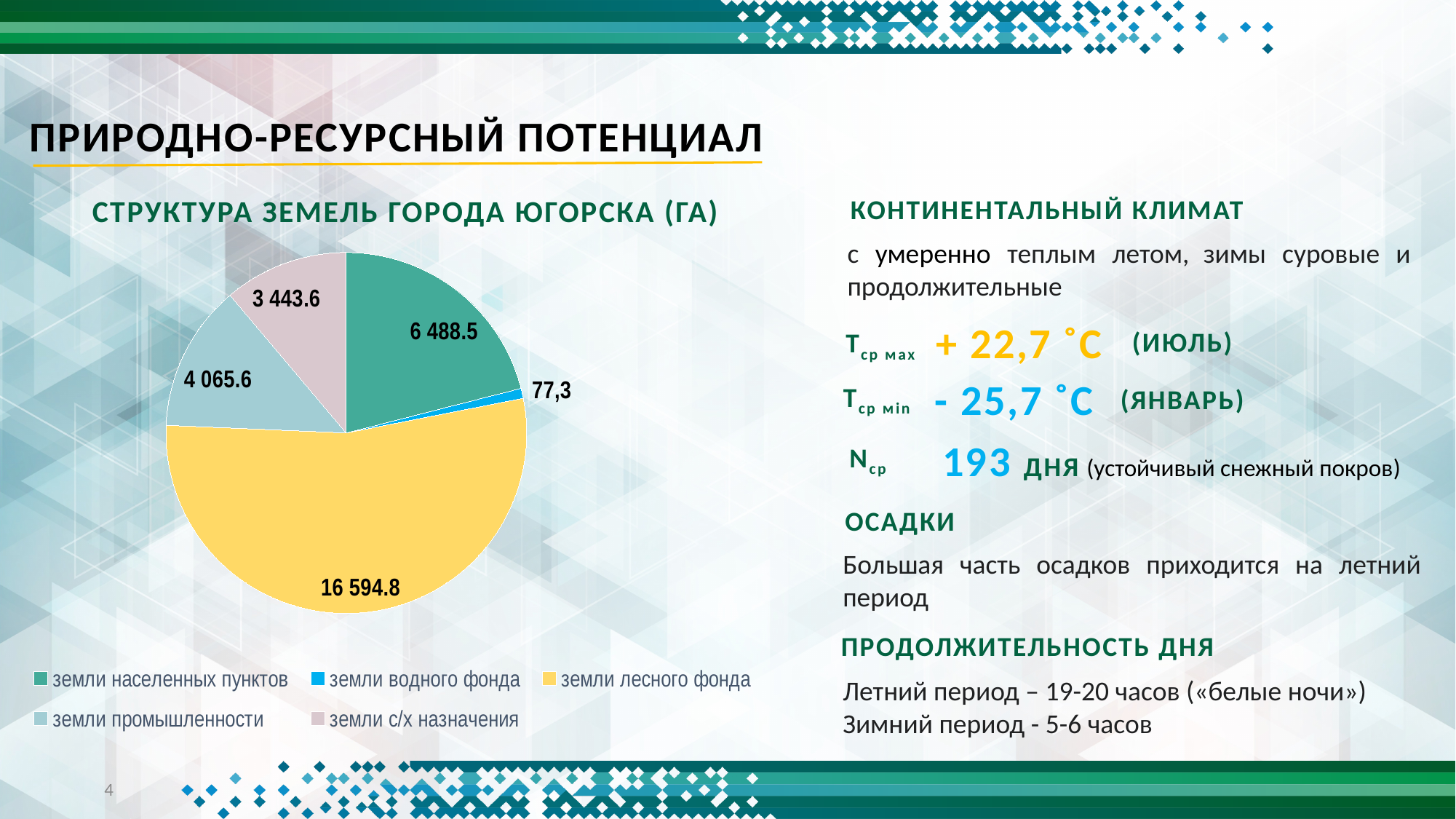
How many categories does the pie chart show? 5 What is the difference between the values for земли лесного фонда and земли населенных пунктов in the pie chart? 10 106.3 What is the value for земли водного фонда in the pie chart? 77,3 What is the value for земли населенных пунктов in the pie chart? 6 488.5 What kind of chart is shown on the slide? Pie chart What is the value for земли промышленности in the pie chart? 4 065.6 Which land category has the smallest slice in the pie chart? земли водного фонда Which is larger in the pie chart: земли промышленности or земли с/х назначения? земли промышленности What is the value for земли лесного фонда in the pie chart? 16 594.8 What is the value for земли с/х назначения in the pie chart? 3 443.6 Which land category has the largest slice in the pie chart? земли лесного фонда What is the title of the pie chart? СТРУКТУРА ЗЕМЕЛЬ ГОРОДА ЮГОРСКА (ГА)